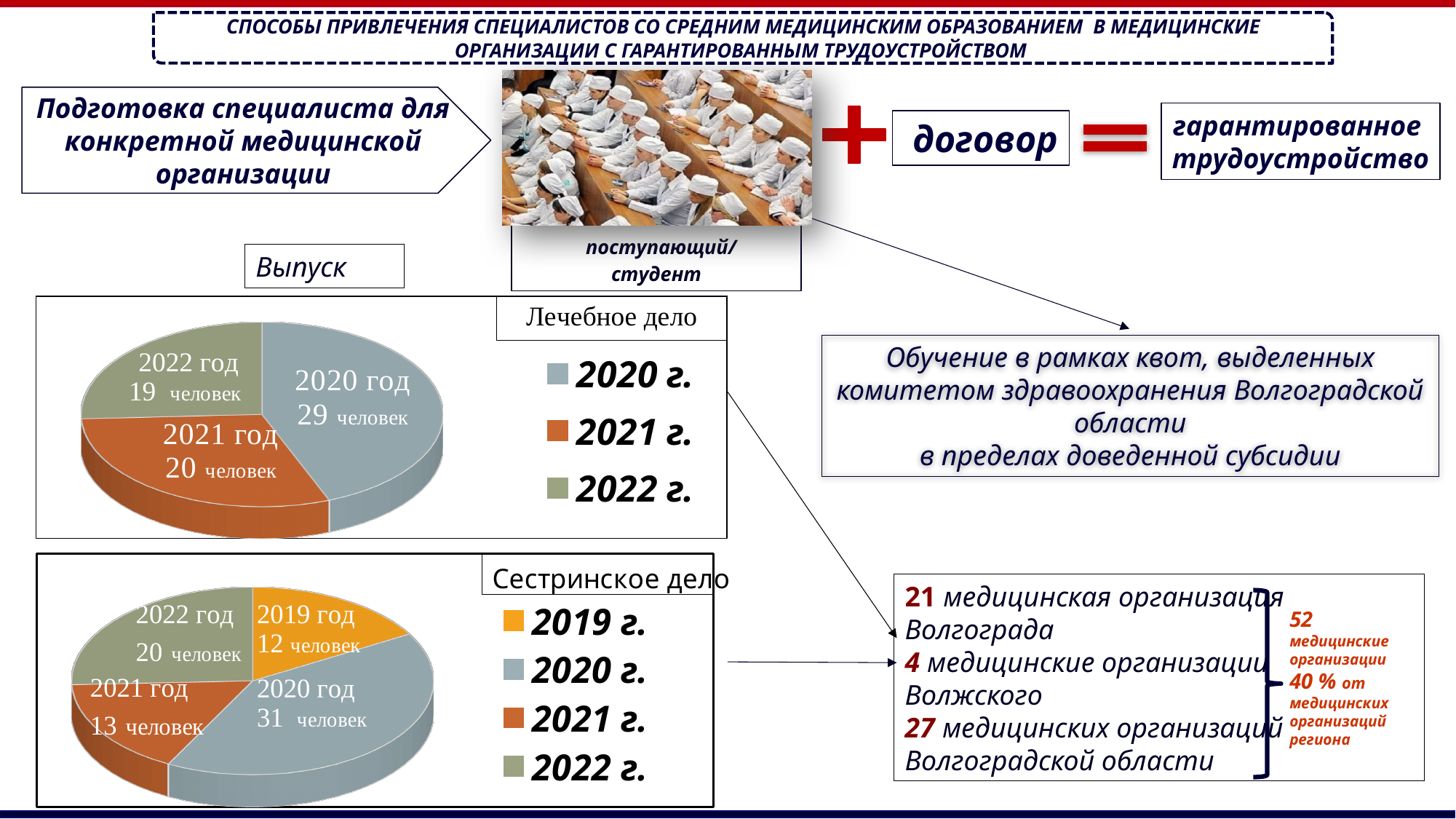
In the "Лечебное дело" chart, what is the difference between the 2020 and 2022 values? 10 In the "Лечебное дело" chart, how many people graduated in 2020? 29 человек In the "Лечебное дело" chart, how many years does the legend list? 3 In the "Сестринское дело" chart, which year has the largest slice? 2020 год In the "Сестринское дело" chart, which year has the smallest slice? 2019 год In the "Лечебное дело" chart, what is the total number of people across all slices? 68 In the "Сестринское дело" chart, how many slices does the pie have? 4 In the "Сестринское дело" chart, which is larger: the value for 2022 or the value for 2021? 2022 In the "Сестринское дело" chart, what colour represents 2019 г. in the legend? Orange/yellow In the "Сестринское дело" chart, how many people are shown for 2021? 13 человек In the "Лечебное дело" chart, which year has the smallest slice? 2022 год What type of chart is used for "Сестринское дело"? Pie chart